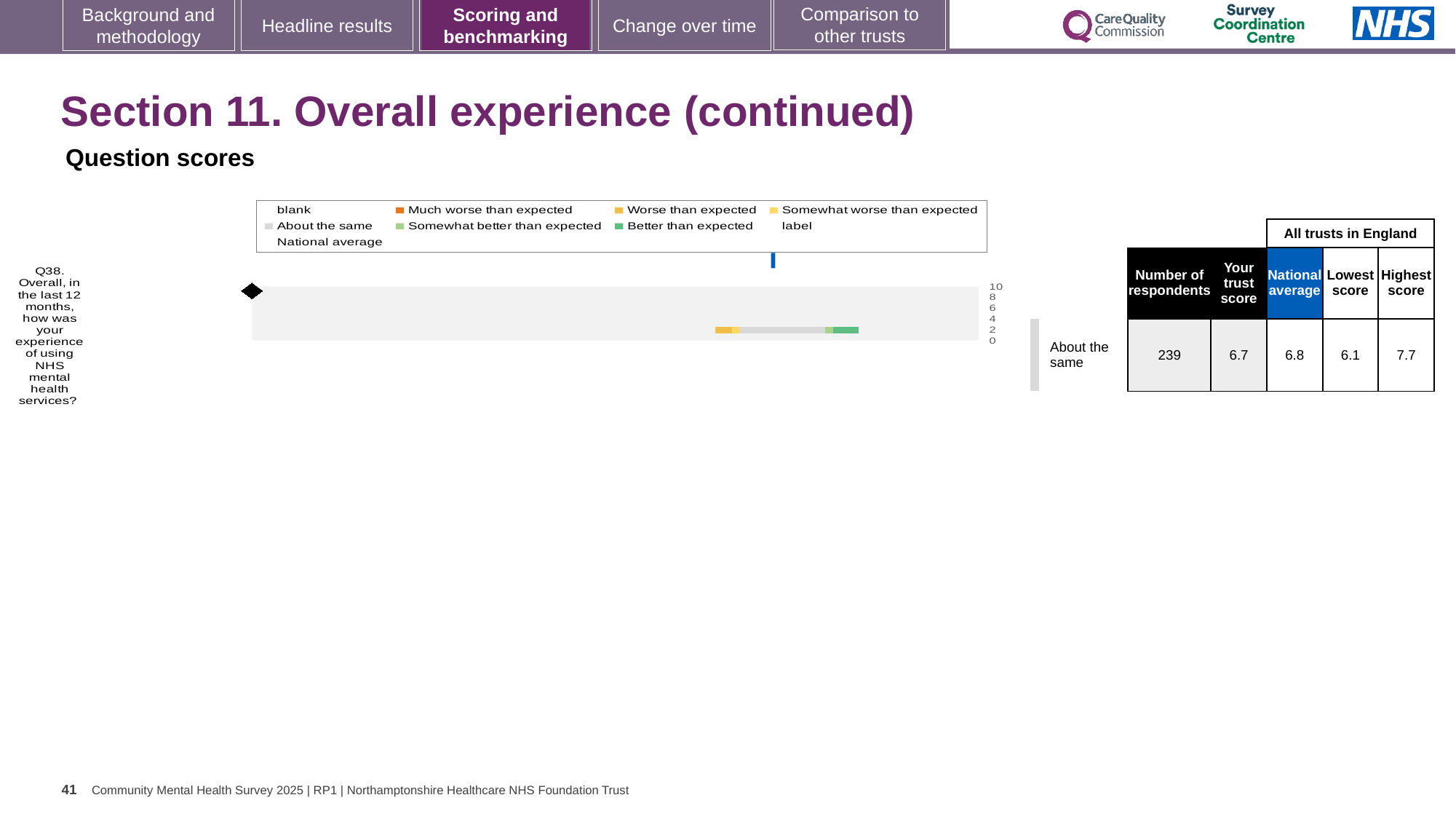
What is the lowest score among all trusts in England for Q38? 6.1 What is the national average score for Q38? 6.8 What kind of chart is used to show the Q38 question score? bar chart What is the difference between the highest and lowest scores among all trusts in England for Q38? 1.6 How many questions are plotted on the chart? 1 By how much does the national average exceed the trust score for Q38? 0.1 How many respondents answered Q38? 239 What is the highest score among all trusts in England for Q38? 7.7 According to the legend, what does the blue vertical line on the chart represent? National average Which benchmark category is Q38 placed in? About the same What is the trust score for Q38 (Overall, in the last 12 months, how was your experience of using NHS mental health services)? 6.7 Which is larger for Q38, the trust score or the national average? National average